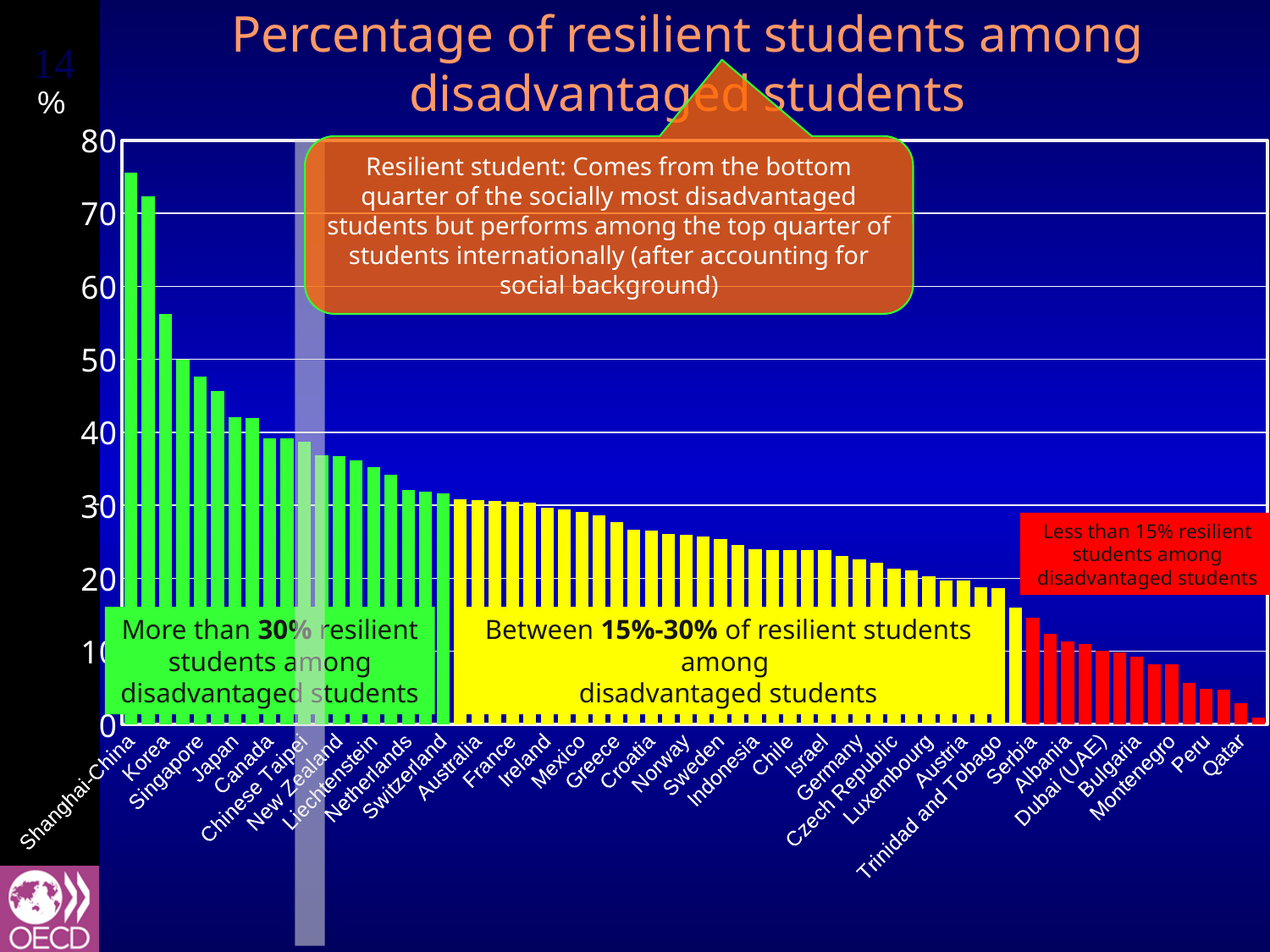
Is the value for Shanghai-China greater or less than 70? greater Is the value for Albania greater or less than 20? less Which country has the highest percentage of resilient students among disadvantaged students? Shanghai-China Is the value for Peru greater or less than 10? less Which has a higher percentage of resilient students, Korea or Japan? Korea Do the values rise or fall moving from left to right along the x axis? fall What colour are the bars for countries with less than 15% resilient students among disadvantaged students? red What kind of chart is shown on the slide? bar chart Which has a higher percentage of resilient students, Canada or Peru? Canada